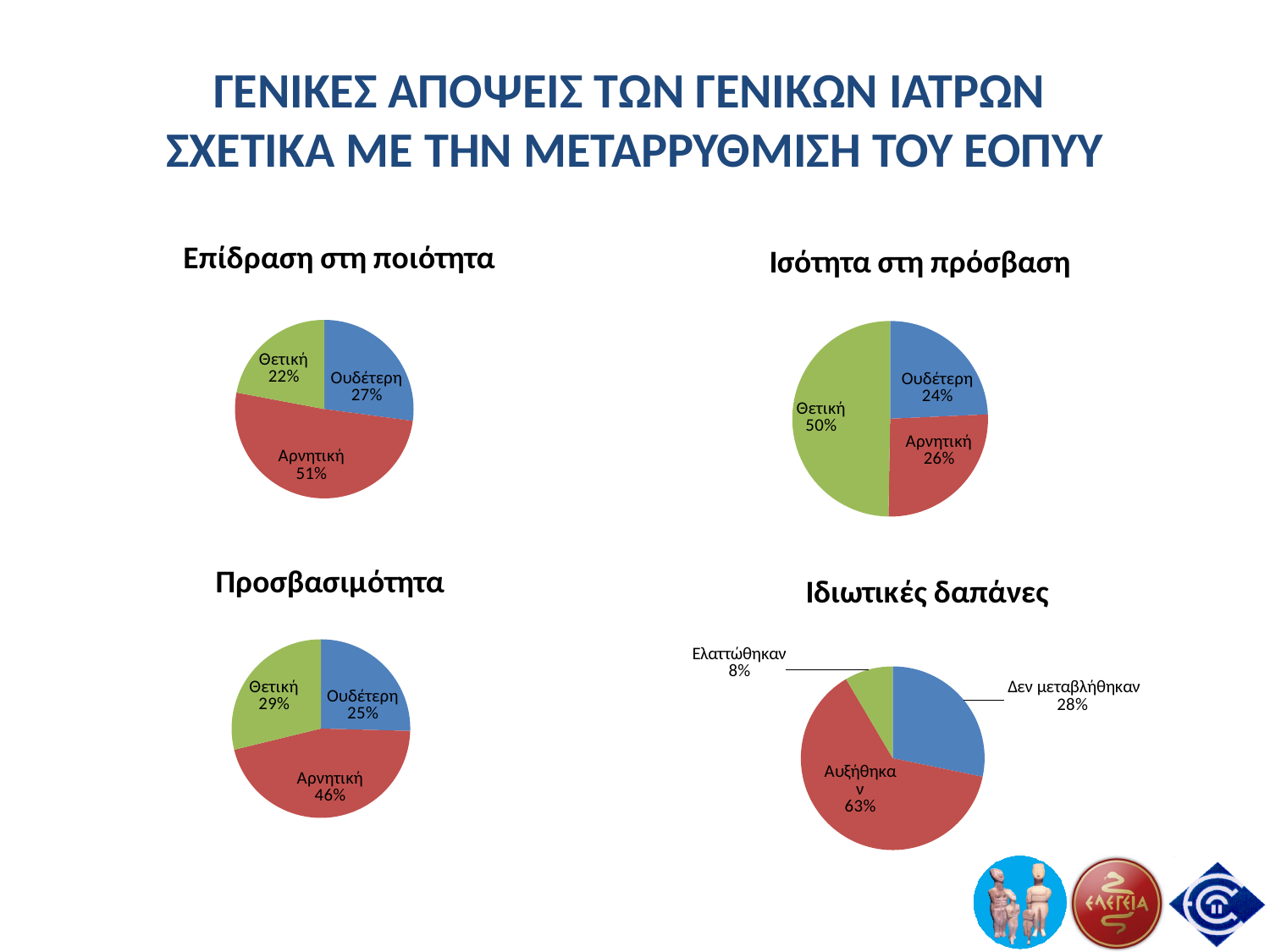
In the 'Ισότητα στη πρόσβαση' chart, what share is labelled 'Θετική'? 50% In the 'Προσβασιμότητα' chart, what share is labelled 'Ουδέτερη'? 25% What type of chart is the 'Προσβασιμότητα' chart? Pie chart Which is larger in the 'Επίδραση στη ποιότητα' chart: the 'Ουδέτερη' share or the 'Θετική' share? Ουδέτερη How many pie charts are shown on the slide? 4 In the 'Επίδραση στη ποιότητα' chart, what share is labelled 'Αρνητική'? 51% In the 'Επίδραση στη ποιότητα' chart, which category has the smallest share? Θετική In the 'Ισότητα στη πρόσβαση' chart, which category has the largest share? Θετική In the 'Προσβασιμότητα' chart, what is the difference between the 'Αρνητική' and 'Θετική' shares? 17% In the 'Ιδιωτικές δαπάνες' chart, what share is labelled 'Ελαττώθηκαν'? 8% In the 'Ιδιωτικές δαπάνες' chart, which category has the largest share? Αυξήθηκαν In the 'Ιδιωτικές δαπάνες' chart, how many slices does the pie have? 3